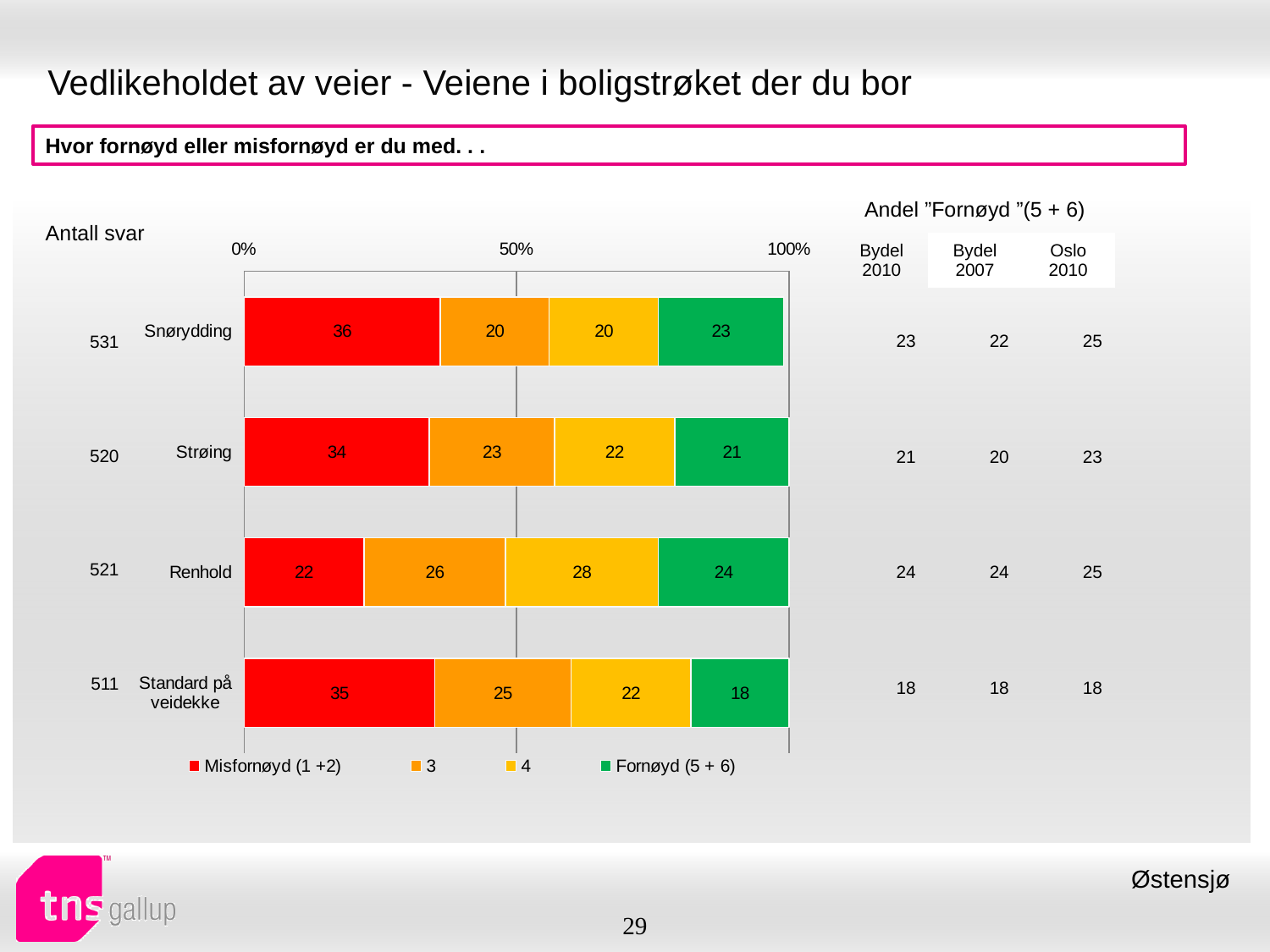
What is the Misfornøyd (1 +2) value for Snørydding? 36 What kind of chart is shown on the slide? stacked bar chart How many series does the chart legend list? 4 How many categories are plotted in the chart? 4 What is the value of series 4 for Strøing? 22 What is the difference between the Misfornøyd (1 +2) values for Standard på veidekke and Renhold? 13 Which is larger: the Fornøyd (5 + 6) value for Snørydding or for Strøing? Snørydding Which category has the lowest Fornøyd (5 + 6) value? Standard på veidekke What is the total of the stacked bar for Renhold? 100 Which category has the highest Misfornøyd (1 +2) value? Snørydding What colour represents the Fornøyd (5 + 6) series in the chart? green What is the Fornøyd (5 + 6) value for Renhold? 24